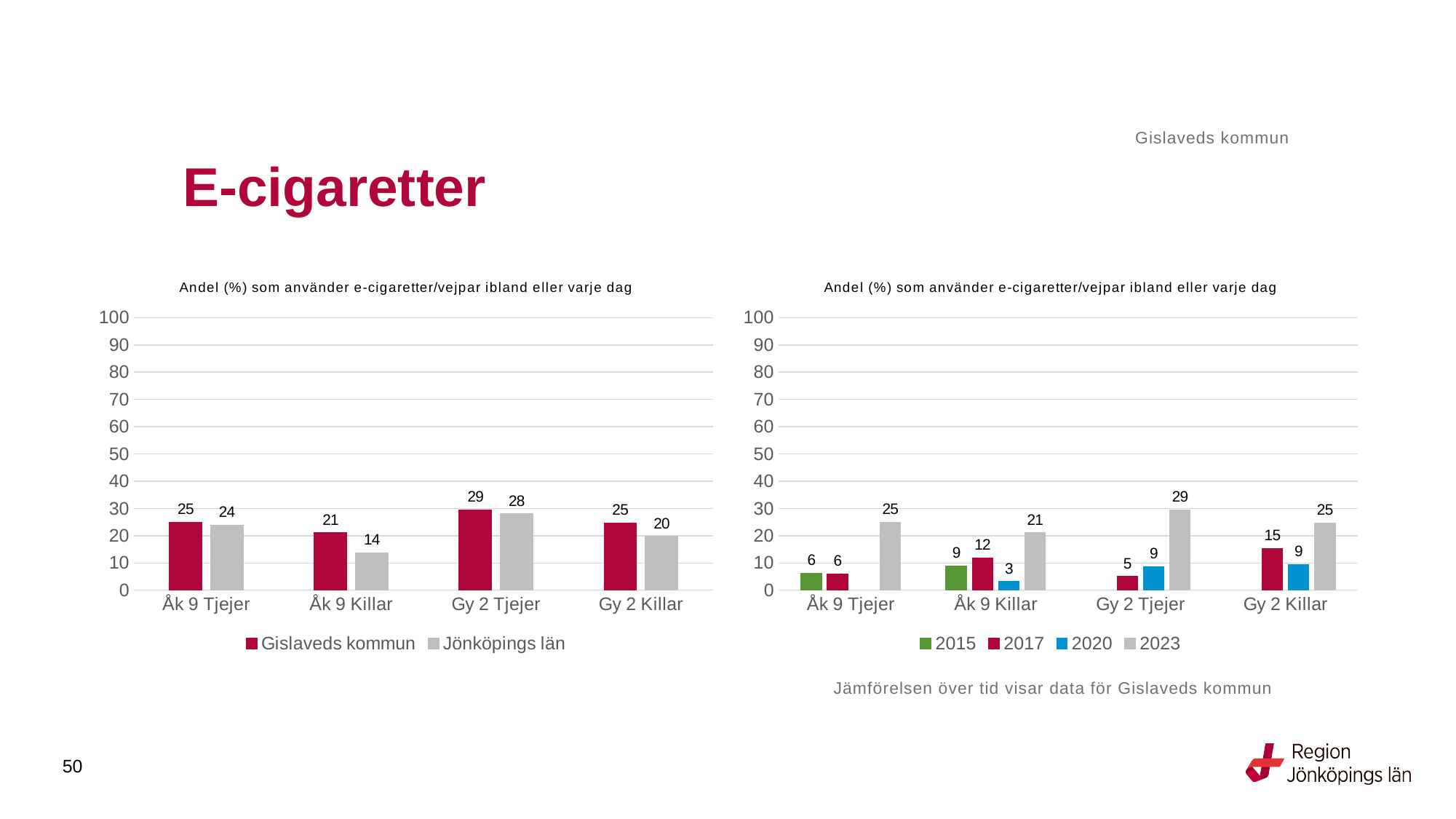
In the left chart, which category has the lowest value for Jönköpings län? Åk 9 Killar In the left chart, what is the value for Jönköpings län for Åk 9 Killar? 14 In the right chart, what is the value for 2020 for Åk 9 Killar? 3 In the left chart, what is the value for Gislaveds kommun for Gy 2 Tjejer? 29 In the right chart, what is the difference between the 2017 and 2023 values for Åk 9 Tjejer? 19 In the left chart, what is the difference between Gislaveds kommun and Jönköpings län for Gy 2 Killar? 5 In the right chart, which is larger for Åk 9 Killar: the 2015 value or the 2017 value? 2017 What kind of chart is the left chart? Bar chart In the right chart, how many series does the legend list? 4 In the right chart, which year has the highest value for Gy 2 Killar? 2023 In the right chart, what is the value for 2023 for Gy 2 Tjejer? 29 In the left chart, how many series does the legend list? 2